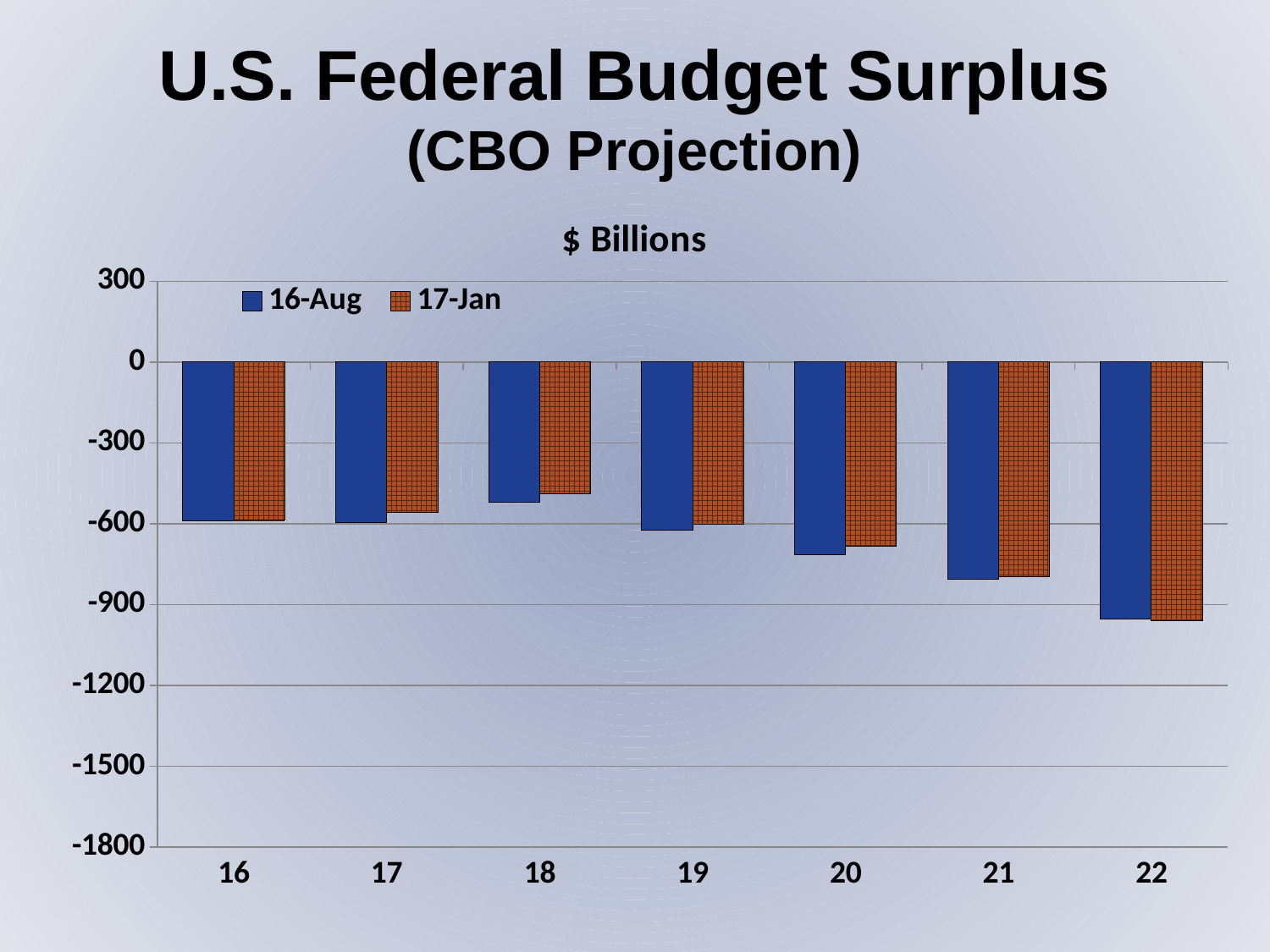
From 18 to 22, do the 16-Aug values rise or fall? fall For the 17-Jan series, which year has the highest (least negative) value? 18 Is the 16-Aug value for 20 greater or less than -600? less How many series does the legend list? 2 For the 16-Aug series, which year has the lowest (most negative) value? 22 What unit label appears above the chart? $ Billions How many years are shown on the x axis? 7 Is the 17-Jan value for 21 greater or less than -900? greater Is the 17-Jan value for 18 greater or less than -600? greater What kind of chart is shown on the slide? bar chart What are the two series named in the legend? 16-Aug and 17-Jan